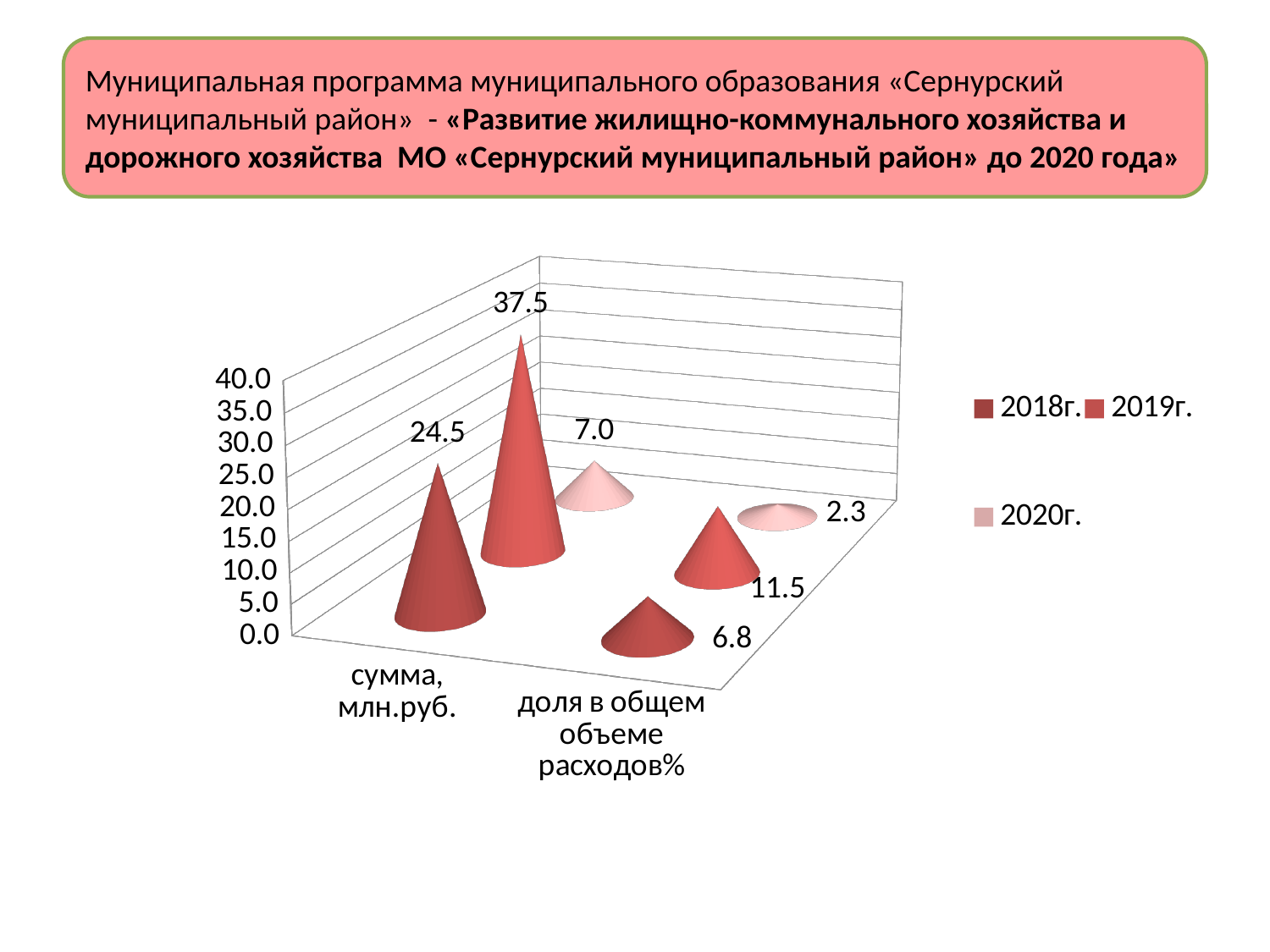
Which year has the lowest value in the category «доля в общем объеме расходов%»? 2020г. What is the value for 2020г. in the category «сумма, млн.руб.»? 7.0 How many series does the legend list? 3 Which year has the highest value in the category «сумма, млн.руб.»? 2019г. What is the value for 2020г. in the category «доля в общем объеме расходов%»? 2.3 What is the value for 2019г. in the category «сумма, млн.руб.»? 37.5 How many categories are shown on the x axis? 2 What is the maximum value shown on the vertical axis? 40.0 What is the value for 2019г. in the category «доля в общем объеме расходов%»? 11.5 What is the value for 2018г. in the category «сумма, млн.руб.»? 24.5 Which is larger in the category «доля в общем объеме расходов%»: the value for 2018г. or for 2019г.? 2019г. What is the difference between the 2019г. and 2018г. values in the category «сумма, млн.руб.»? 13.0